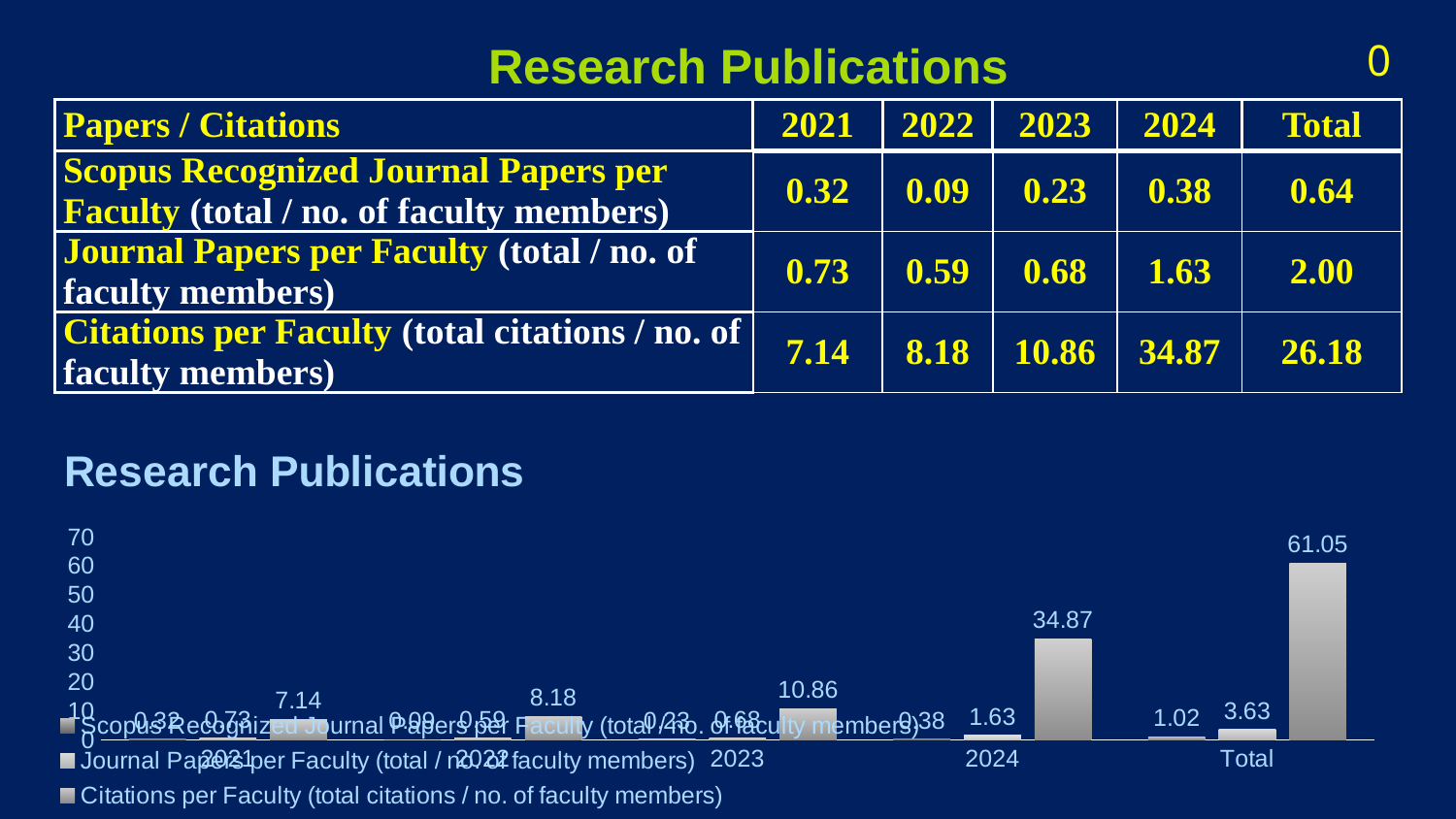
In the chart, what is the value of Journal Papers per Faculty for 2024? 1.63 In the chart, what is the difference between Citations per Faculty in 2024 and in 2023? 24.01 How many categories are shown along the x axis of the chart? 5 What type of chart is shown on the slide? bar chart In the chart, what is the value of Citations per Faculty for 2024? 34.87 In the chart, which year has the lowest Scopus Recognized Journal Papers per Faculty value? 2022 In the chart, is Citations per Faculty higher in 2022 or in 2021? 2022 How many series does the chart legend list? 3 In the chart, what is the value of Scopus Recognized Journal Papers per Faculty for 2022? 0.09 In the chart, which year has the highest Citations per Faculty value among 2021 to 2024? 2024 In the chart, what is the value of Citations per Faculty for the Total category? 61.05 Does the Citations per Faculty value rise or fall from 2021 to 2024 in the chart? rise